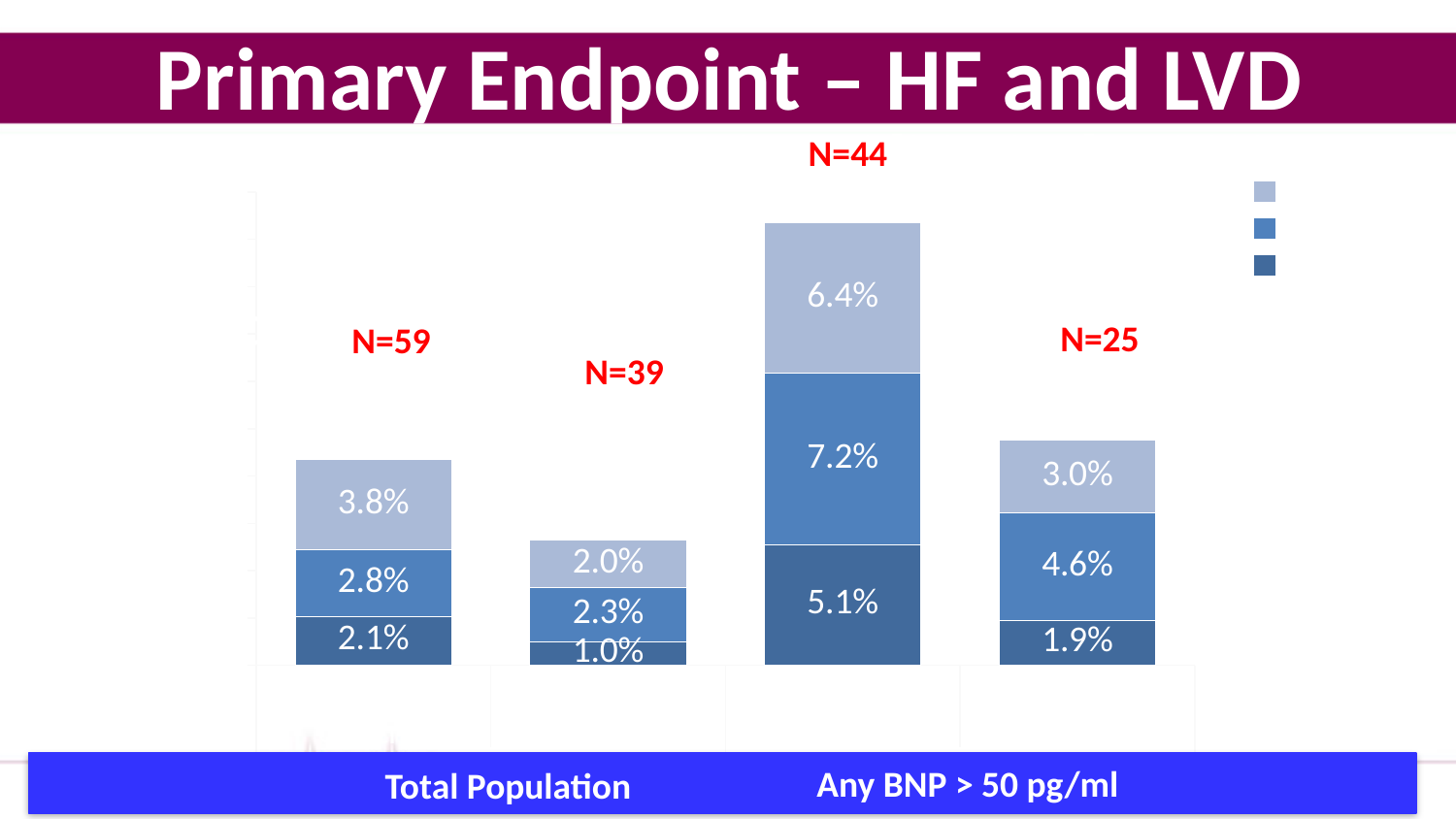
Which bar is the tallest overall? The bar labelled N=44 (third from left) What is the difference between the middle segment of the N=44 bar and the middle segment of the N=25 bar? 2.6 percentage points How many series does the legend list? 3 What is the total of the stacked bar labelled N=59? 8.7% What is the value of the top (lightest) segment of the bar labelled N=25? 3.0% What kind of chart is shown on the slide? Stacked bar chart What is the value of the bottom (darkest) segment of the bar labelled N=44? 5.1% How many bars are plotted in the chart? 4 What is the title of the slide? Primary Endpoint – HF and LVD Which bar is the shortest overall? The bar labelled N=39 (second from left) What is the value of the middle segment of the bar labelled N=59? 2.8% What is the total of the stacked bar labelled N=44? 18.7%